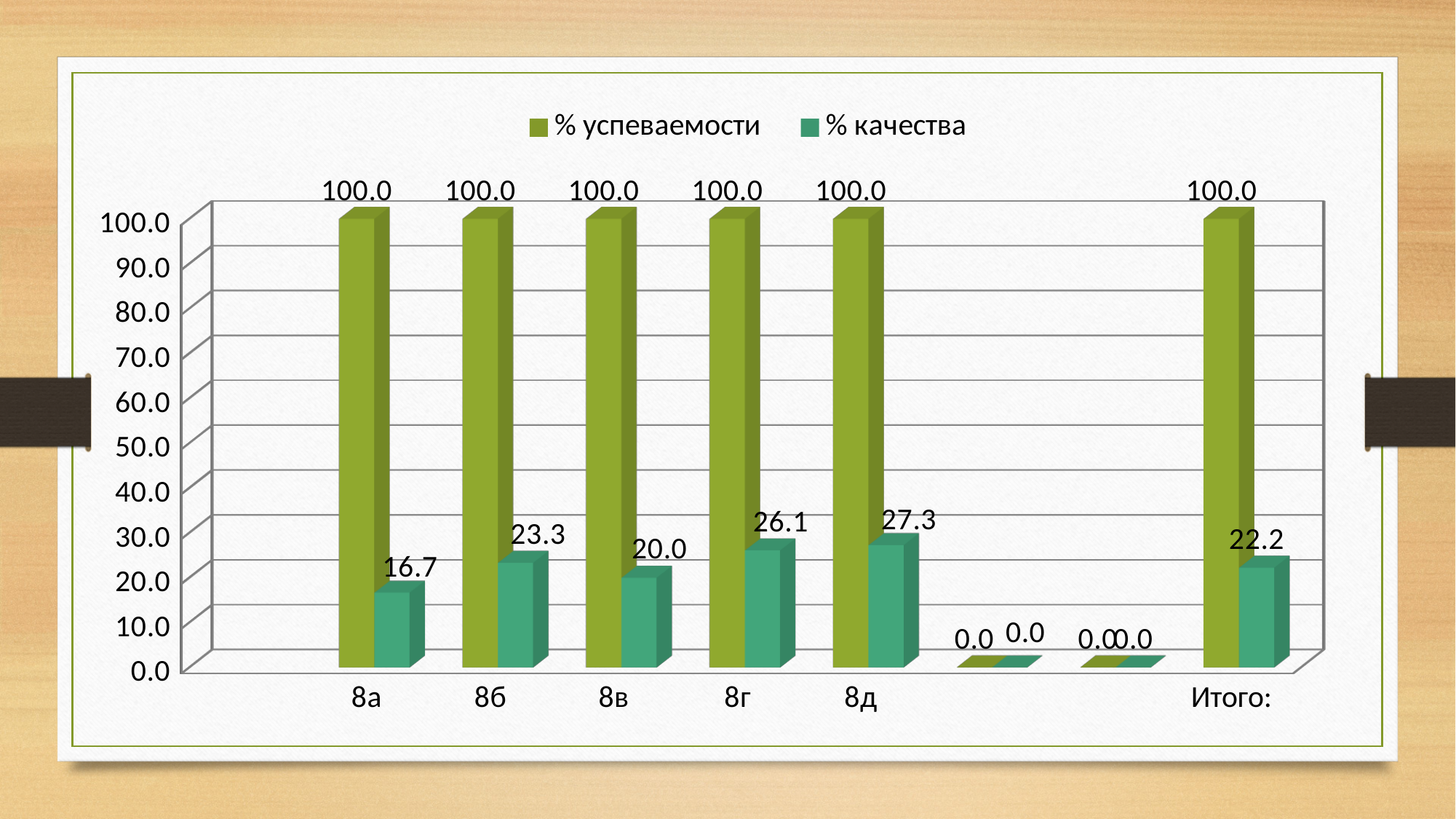
What is the value of % успеваемости for 8в? 100.0 Which class among 8а, 8б, 8в, 8г and 8д has the highest % качества? 8д How many series does the legend list? 2 Which has a larger % качества value, 8б or 8в? 8б What is the difference between the % качества values for 8д and 8а? 10.6 What is the value of % качества for 8а? 16.7 Which class among 8а, 8б, 8в, 8г and 8д has the lowest % качества? 8а What is the value of % качества for 8д? 27.3 Is the % качества value for 8г greater or less than 30? less What is the value of % качества for Итого:? 22.2 What are the two series named in the legend? % успеваемости and % качества What kind of chart is shown on the slide? bar chart